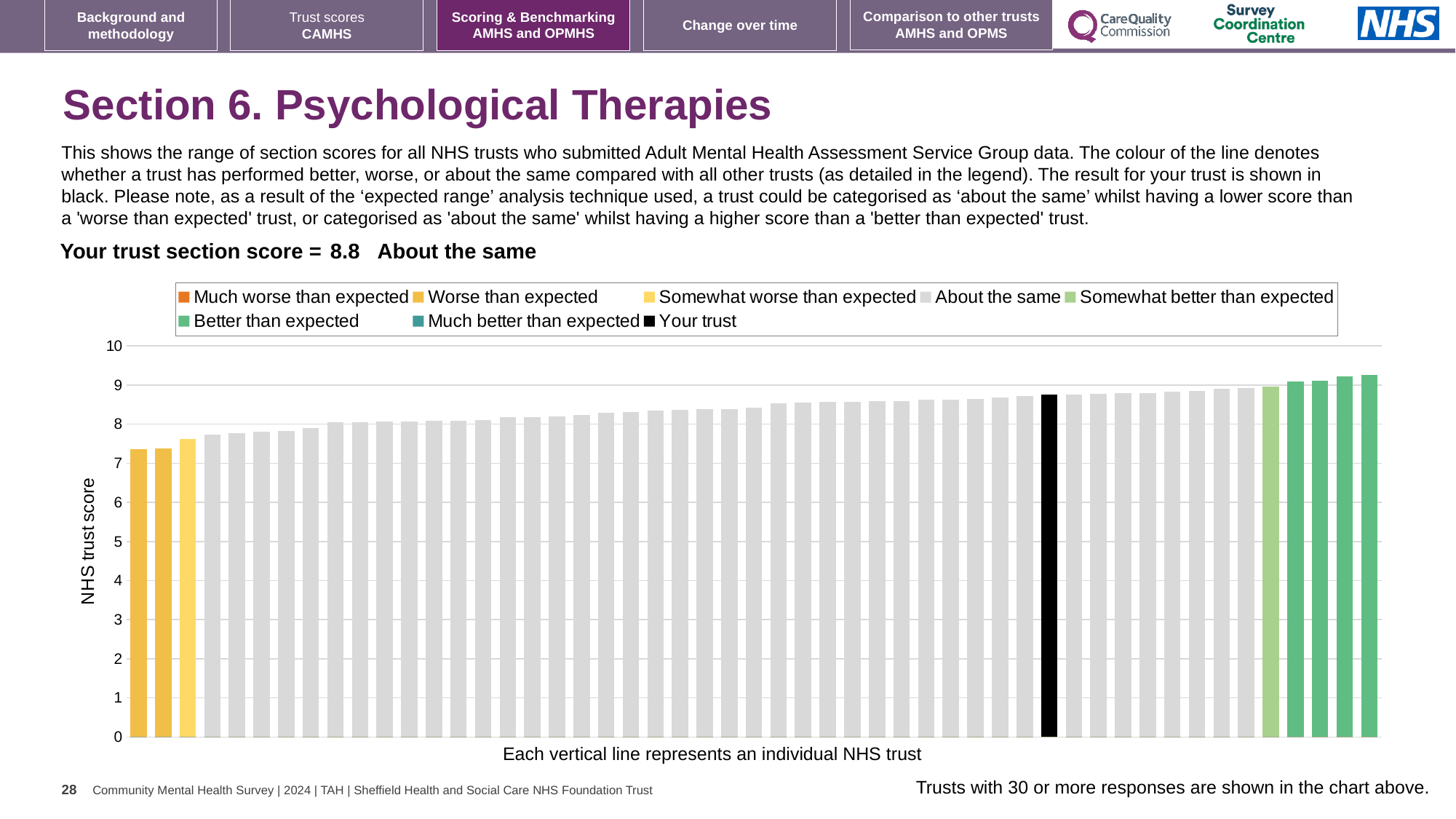
How many entries does the chart legend list? 8 Which legend category does the highest bar in the chart belong to? Better than expected Do the bar values rise or fall from left to right along the x axis? rise What is the section score for your trust shown on the slide? 8.8 Is the value for Your trust greater or less than 8? greater How many bars are coloured as 'Better than expected' (dark green)? 4 Which legend category does the lowest bar in the chart belong to? Worse than expected What kind of chart is shown on the slide? bar chart Is the value of the rightmost (highest) bar greater or less than 9? greater Is the value for Your trust greater or less than 9? less What is the title of the vertical axis of the chart? NHS trust score